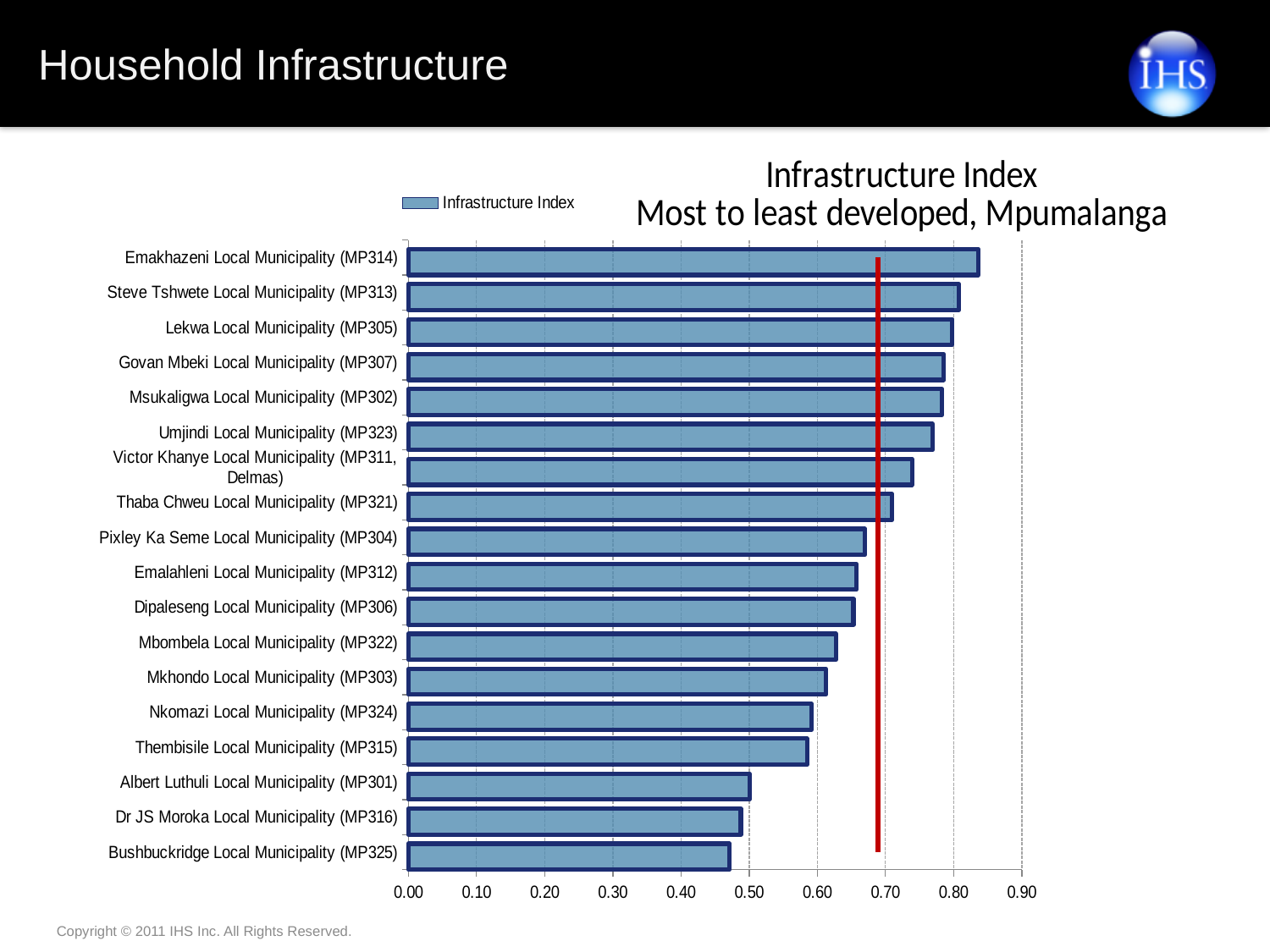
Which municipality has the lowest Infrastructure Index? Bushbuckridge Local Municipality (MP325) What kind of chart is shown on the slide? bar chart Which has a higher Infrastructure Index, Mbombela Local Municipality (MP322) or Lekwa Local Municipality (MP305)? Lekwa Local Municipality (MP305) What is the name of the series shown in the legend? Infrastructure Index Is the Infrastructure Index for Umjindi Local Municipality (MP323) greater or less than 0.70? greater Do the Infrastructure Index values increase or decrease going from the top bar to the bottom bar? decrease Is the Infrastructure Index for Emakhazeni Local Municipality (MP314) greater or less than 0.80? greater Is the Infrastructure Index for Pixley Ka Seme Local Municipality (MP304) greater or less than 0.70? less How many municipalities are plotted in the chart? 18 Which municipality has the highest Infrastructure Index? Emakhazeni Local Municipality (MP314) How many series does the legend list? 1